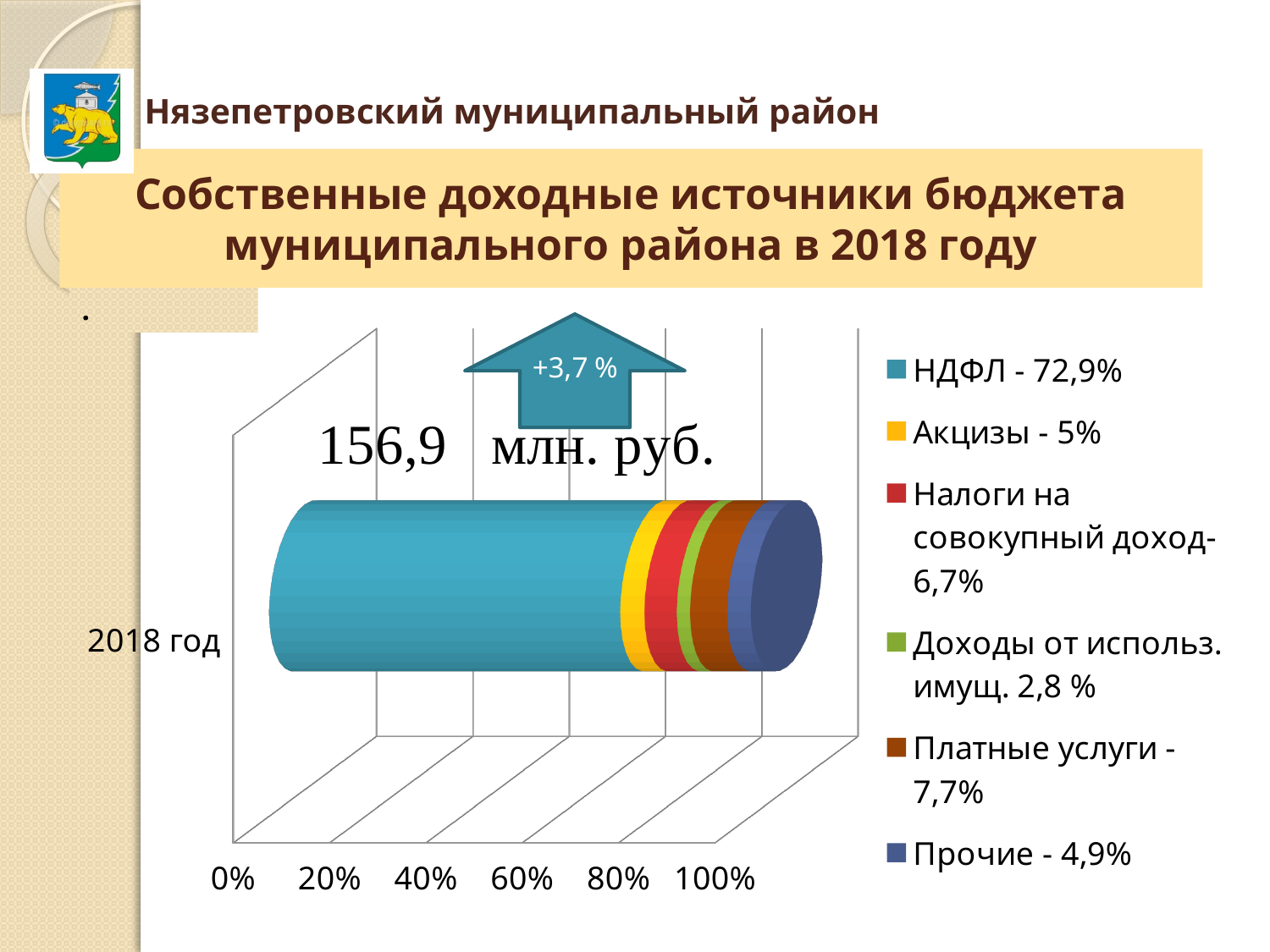
What kind of chart is shown on the slide? bar chart How many series does the legend list? 6 What percentage change is shown in the arrow above the bar? +3,7 % Which revenue source has the smallest share in the chart? Доходы от использ. имущ. What is the difference between the share of Платные услуги (7,7%) and the share of Прочие (4,9%)? 2,8% What share is shown for Платные услуги in the legend? 7,7% What total amount in million rubles is printed above the bar? 156,9 млн. руб. What share is shown for Доходы от использ. имущ. in the legend? 2,8 % Which revenue source has the largest share in the chart? НДФЛ Which is larger: the share of Платные услуги or the share of Налоги на совокупный доход? Платные услуги What share of the 2018 budget revenue does НДФЛ account for, according to the legend? 72,9% What share is shown for Акцизы in the legend? 5%